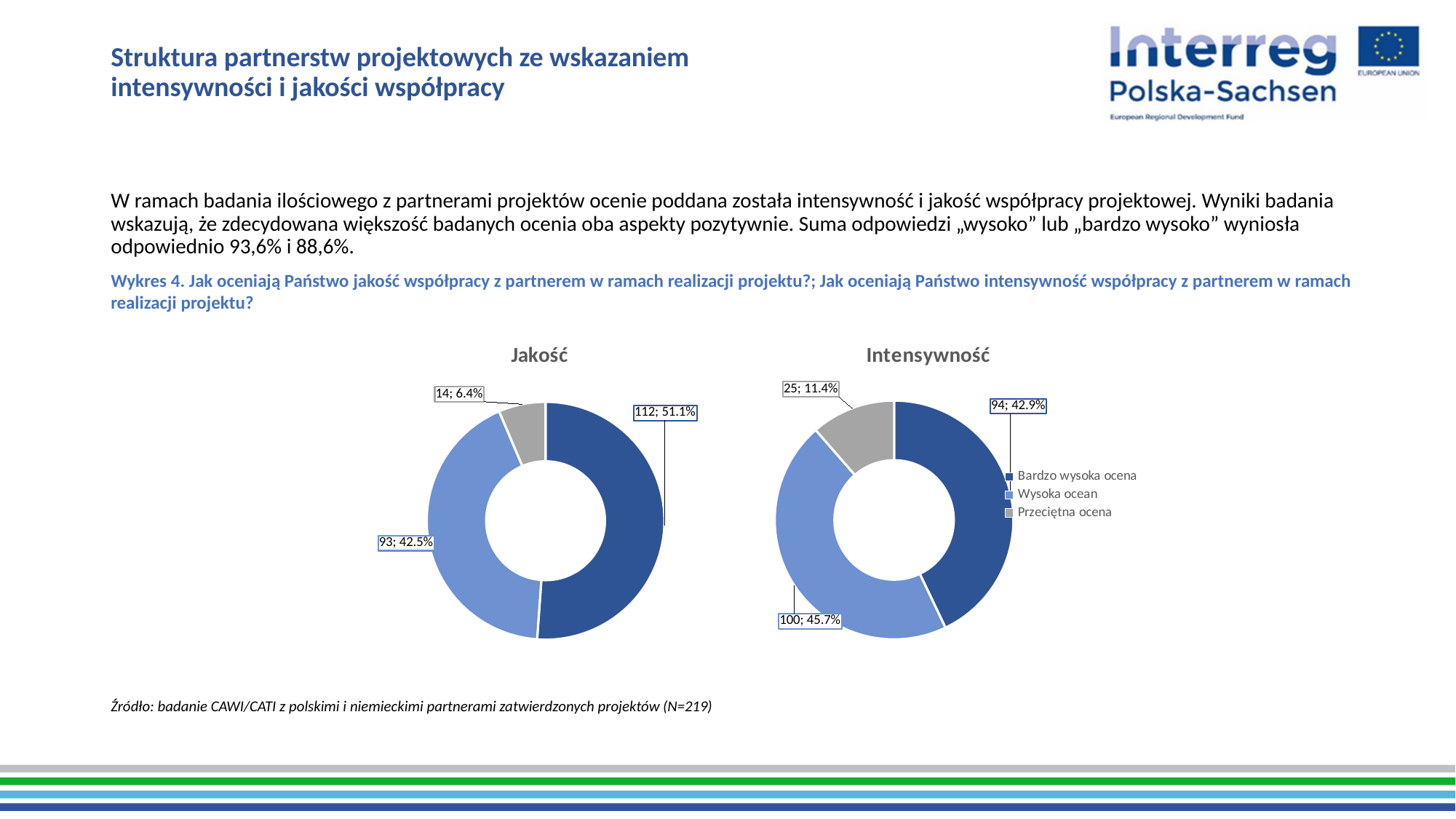
How many categories does the legend list for the charts? 3 In the "Intensywność" chart, what share does "Bardzo wysoka ocena" have? 42.9% In the "Jakość" chart, what is the count for "Przeciętna ocena"? 14 In the "Jakość" chart, what is the difference in count between "Bardzo wysoka ocena" and "Wysoka ocean"? 19 In the "Jakość" chart, what share does "Wysoka ocean" have? 42.5% In the "Jakość" chart, what is the count for "Bardzo wysoka ocena"? 112 What type of chart is the "Intensywność" chart? Doughnut (pie) chart In the "Jakość" chart, which category has the largest slice? Bardzo wysoka ocena In the "Intensywność" chart, which category has the smallest slice? Przeciętna ocena In the "Intensywność" chart, which is larger: "Bardzo wysoka ocena" or "Wysoka ocean"? Wysoka ocean In the "Intensywność" chart, what is the count for "Wysoka ocean"? 100 In the "Intensywność" chart, what share does "Przeciętna ocena" have? 11.4%